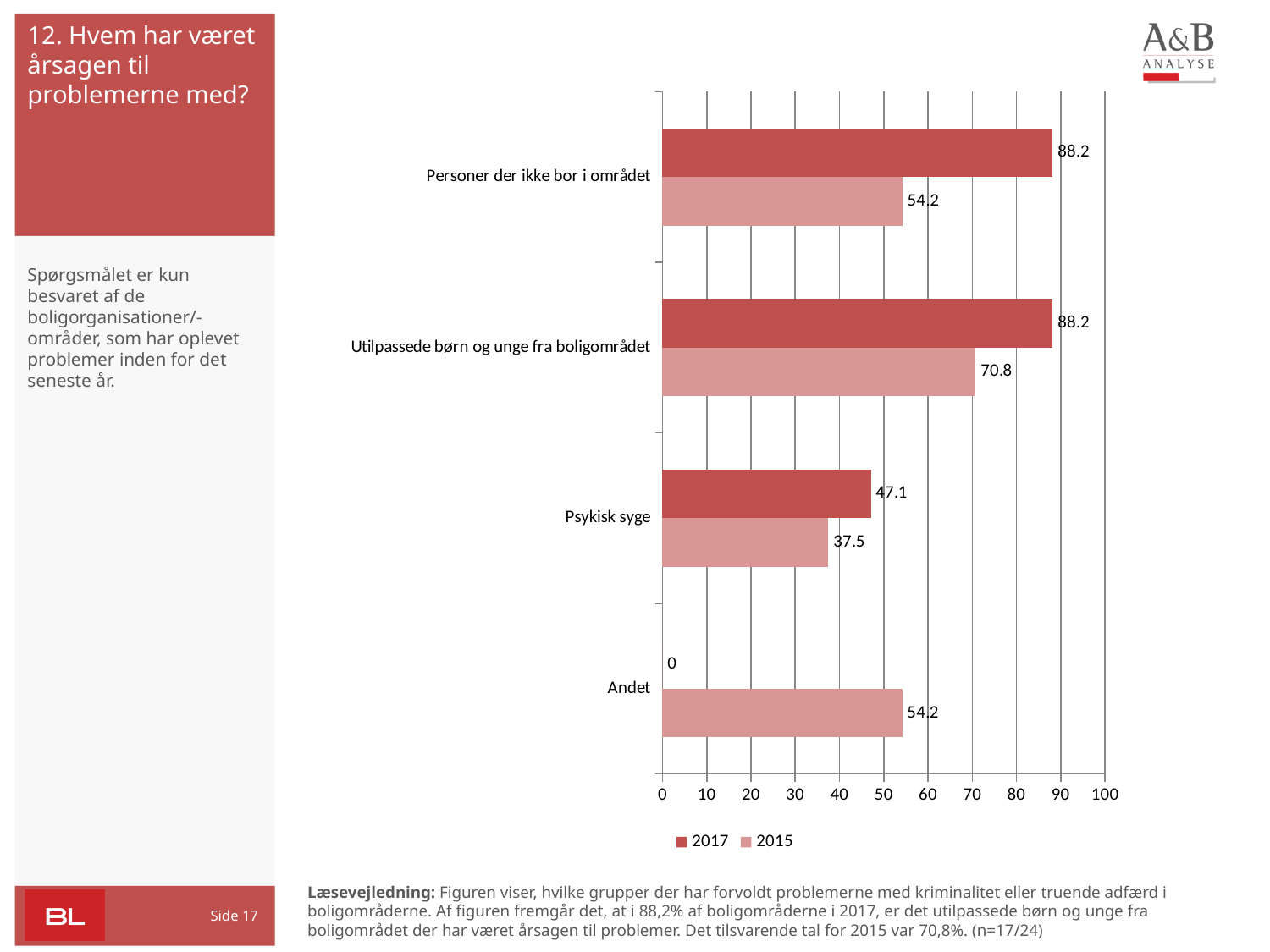
What is the 2017 value for Psykisk syge? 47.1 How many categories are shown on the chart? 4 Which series is shown in the darker red colour? 2017 What is the 2015 value for Utilpassede børn og unge fra boligområdet? 70.8 What is the 2017 value for Personer der ikke bor i området? 88.2 How many series does the legend list? 2 Which is larger for Psykisk syge, the 2017 value or the 2015 value? 2017 Which category has the highest 2015 value? Utilpassede børn og unge fra boligområdet What is the difference between the 2017 and 2015 values for Personer der ikke bor i området? 34 What kind of chart is shown on the slide? bar chart What is the 2015 value for Andet? 54.2 Which category has the lowest 2017 value? Andet